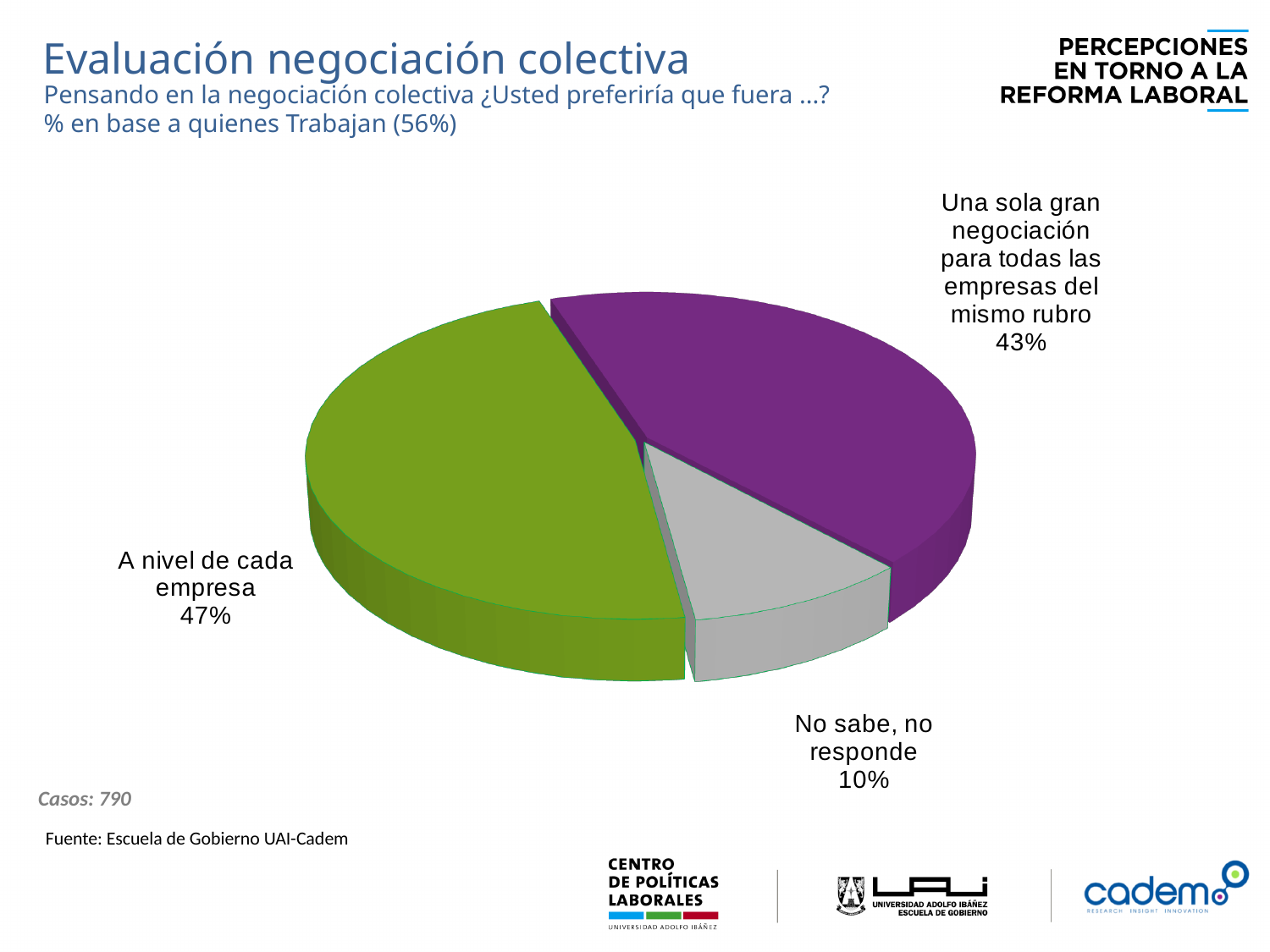
Which is larger: the share for 'A nivel de cada empresa' or the share for 'No sabe, no responde'? A nivel de cada empresa How many cases (Casos) does the slide report for this chart? 790 How many slices does the pie chart have? 3 What percentage of respondents prefer 'Una sola gran negociación para todas las empresas del mismo rubro'? 43% What is the difference in percentage points between 'A nivel de cada empresa' and 'Una sola gran negociación para todas las empresas del mismo rubro'? 4 percentage points What colour is the slice for 'A nivel de cada empresa'? Green Which option has the smallest share of the pie? No sabe, no responde What percentage of respondents answered 'No sabe, no responde'? 10% What percentage of respondents prefer negotiation 'A nivel de cada empresa'? 47% Which option has the largest share of the pie? A nivel de cada empresa What is the combined share of 'A nivel de cada empresa' and 'Una sola gran negociación para todas las empresas del mismo rubro'? 90% What type of chart is shown on the slide? Pie chart